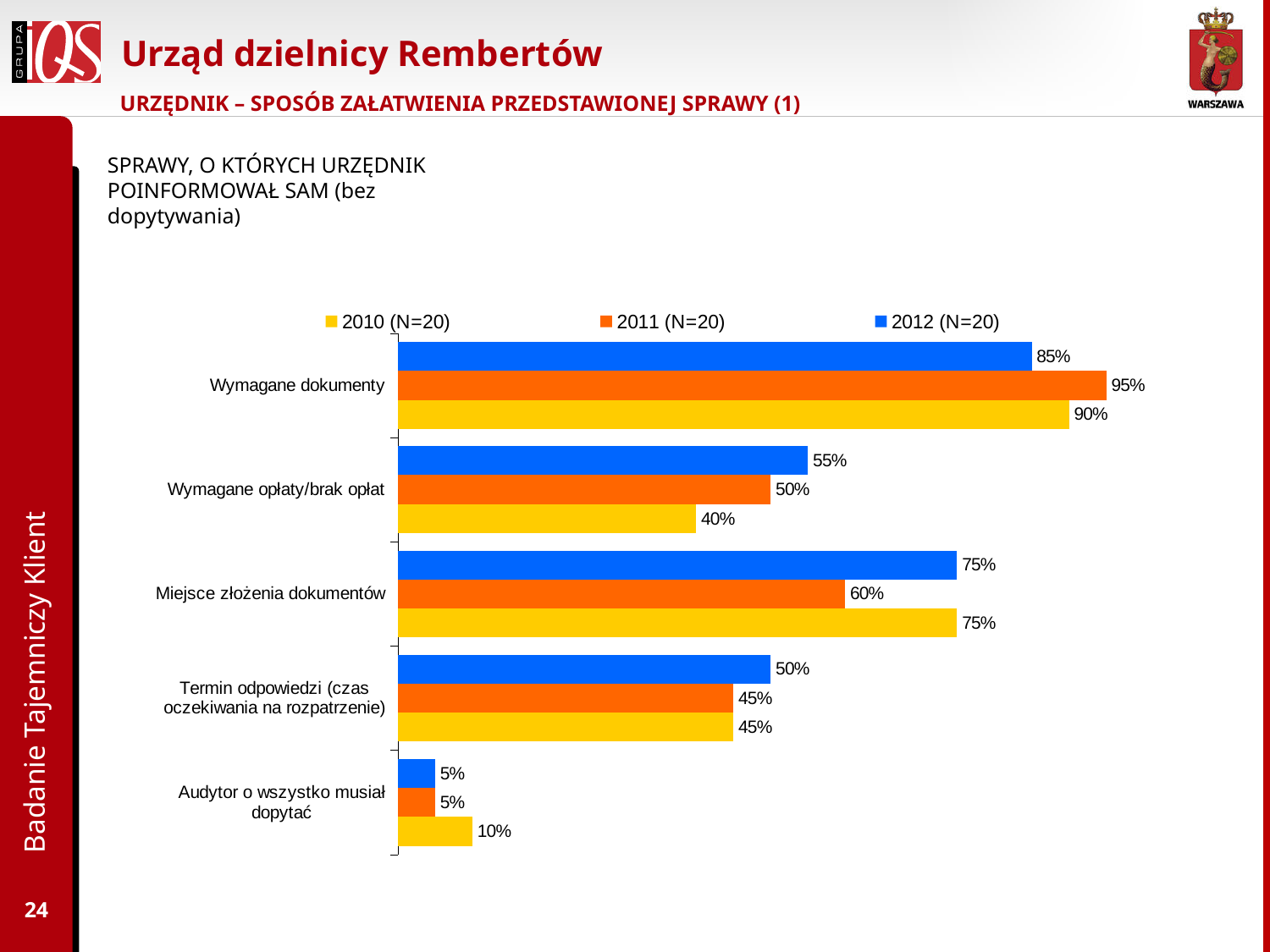
What is the value for 'Termin odpowiedzi (czas oczekiwania na rozpatrzenie)' in the 2012 (N=20) series? 50% What is the value for 'Wymagane opłaty/brak opłat' in the 2010 (N=20) series? 40% How many series does the legend list? 3 What kind of chart is shown on the slide? Bar chart How many categories are shown on the chart? 5 For 'Wymagane opłaty/brak opłat', which series has the larger value: 2010 (N=20) or 2012 (N=20)? 2012 (N=20) Which colour represents the 2011 (N=20) series in the legend? Orange Which category has the lowest value in the 2010 (N=20) series? Audytor o wszystko musiał dopytać What is the value for 'Wymagane dokumenty' in the 2011 (N=20) series? 95% What is the difference between the 2011 and 2012 values for 'Miejsce złożenia dokumentów'? 15% Which category has the highest value in the 2012 (N=20) series? Wymagane dokumenty What is the value for 'Miejsce złożenia dokumentów' in the 2012 (N=20) series? 75%